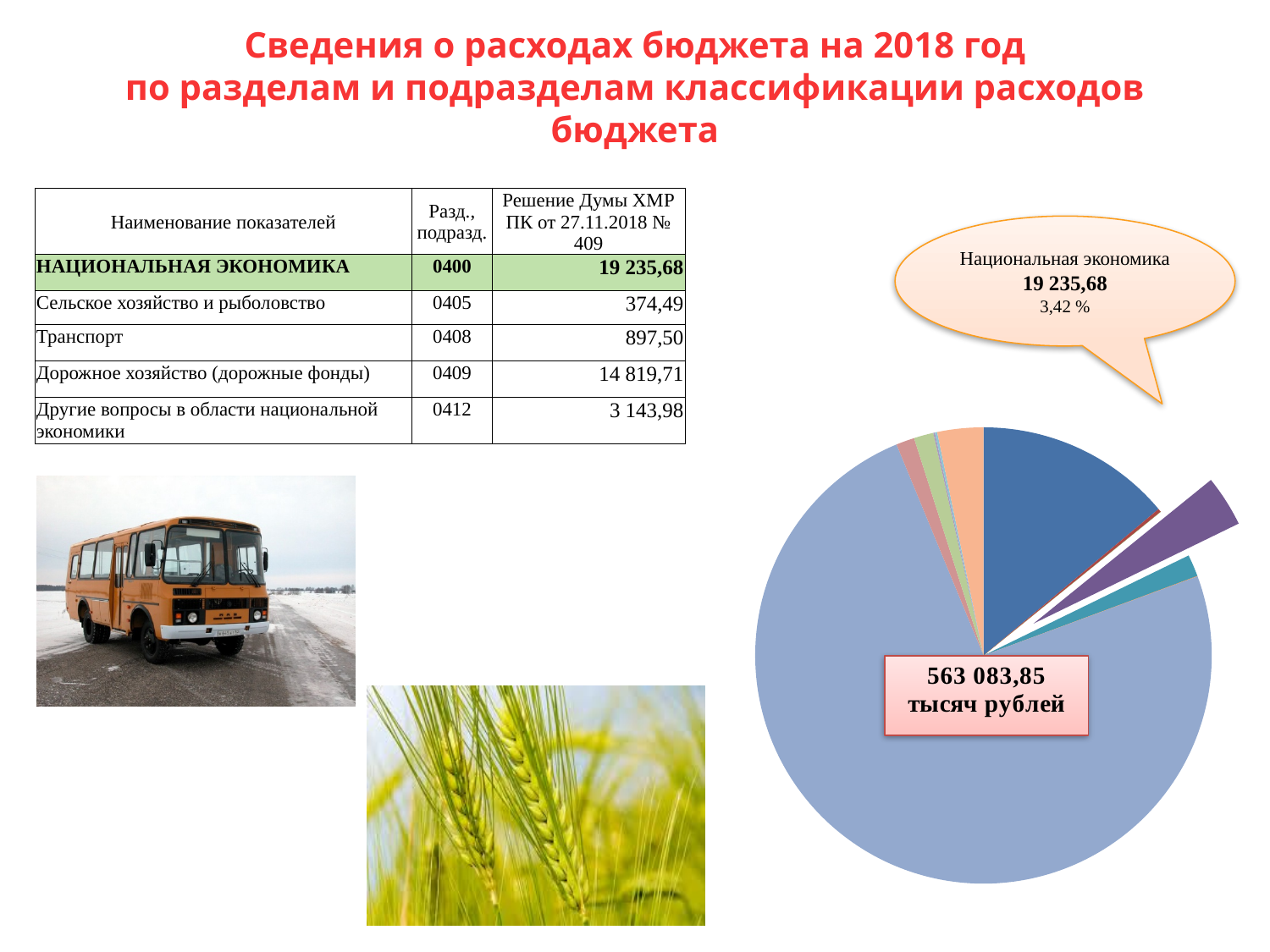
What kind of chart is shown on the right side of the slide? pie chart According to the callout on the pie chart, what is the value for Национальная экономика? 19 235,68 Which slice of the pie chart is pulled out (exploded) from the rest? the purple slice According to the callout on the pie chart, what share of the pie does Национальная экономика represent? 3,42 % Is the slice for Национальная экономика the largest slice of the pie chart? No Does the pie chart have a legend? No What total amount is printed in the box on the pie chart? 563 083,85 тысяч рублей